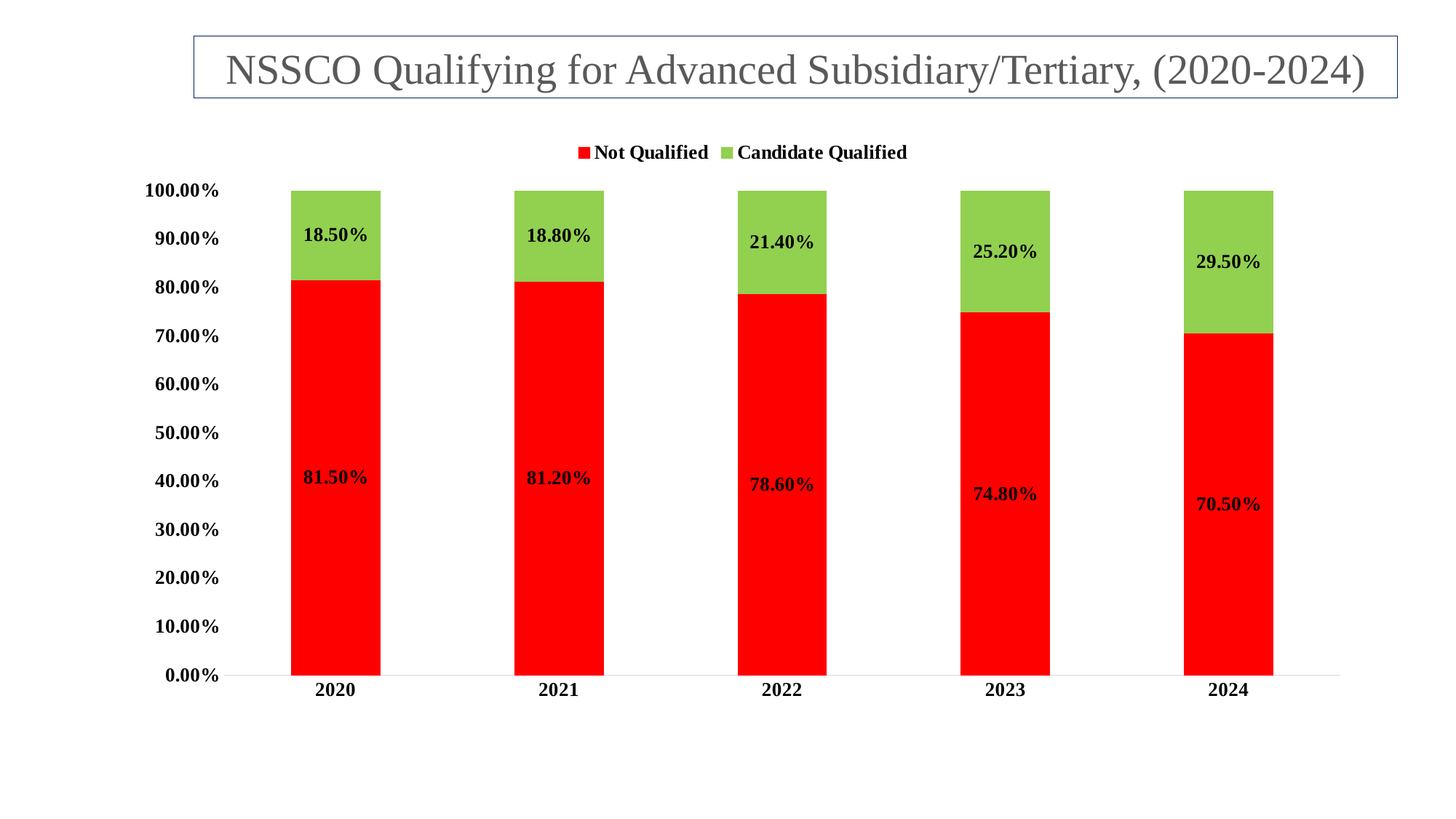
Which colour represents the Not Qualified series? Red Which is larger, the Candidate Qualified value for 2023 or for 2021? 2023 Which year has the highest Candidate Qualified percentage? 2024 How many years are shown on the x axis? 5 What kind of chart is shown on the slide? Stacked bar chart Does the Candidate Qualified percentage rise or fall from 2020 to 2024? Rise What percentage of candidates were Not Qualified in 2020? 81.50% What is the difference between the Not Qualified percentages for 2020 and 2024? 11.00% What is the Candidate Qualified value for 2022? 21.40% What is the Candidate Qualified value for 2024? 29.50% How many series does the legend list? 2 Which year has the lowest Not Qualified percentage? 2024